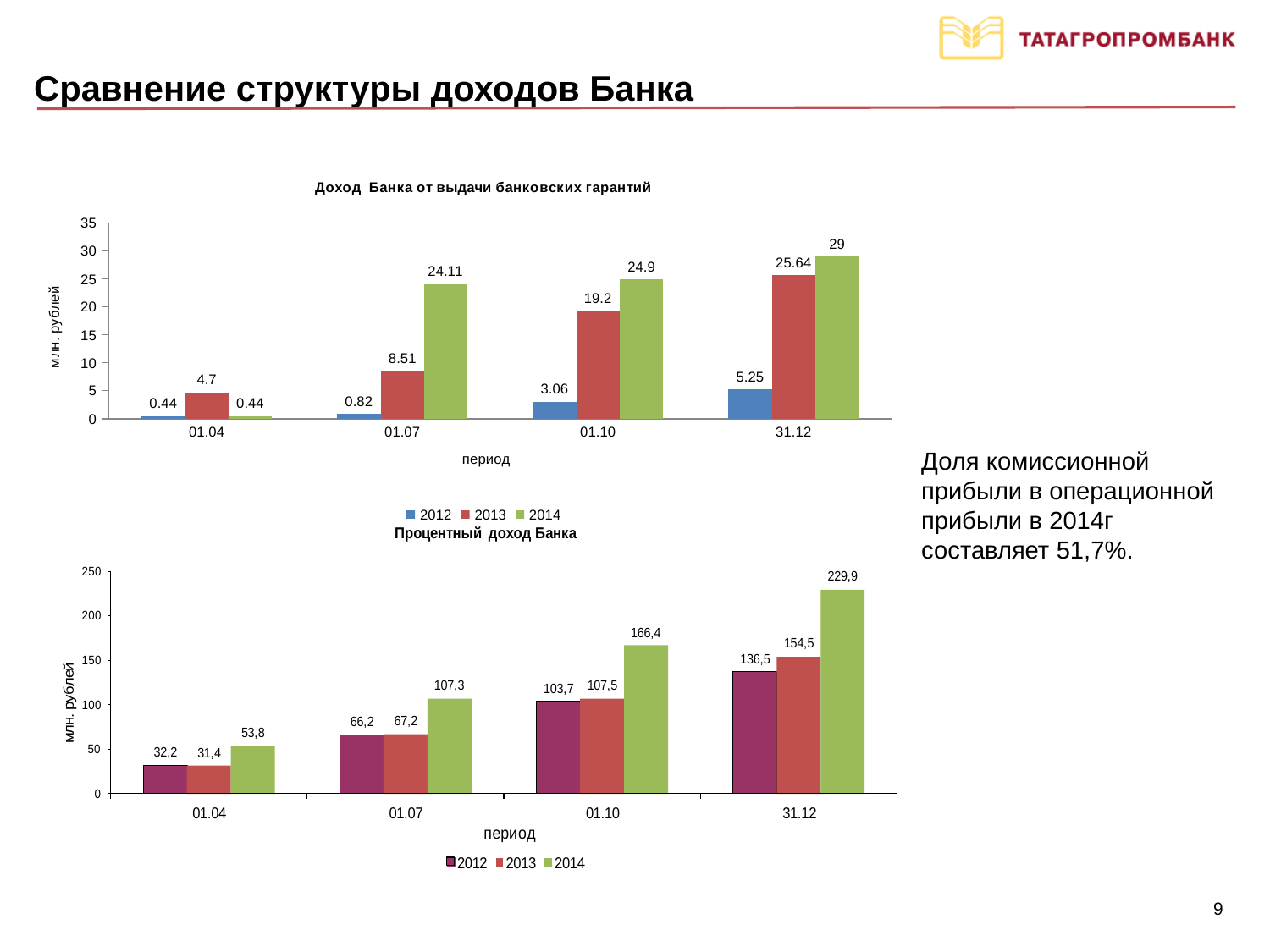
In the chart 'Доход Банка от выдачи банковских гарантий', how many series does the legend list? 3 In the chart 'Процентный доход Банка', what is the value for 2012 at 01.10? 103,7 In the chart 'Процентный доход Банка', what is the value for 2014 at 31.12? 229,9 In the chart 'Процентный доход Банка', which period has the lowest value for the 2014 series? 01.04 In the chart 'Доход Банка от выдачи банковских гарантий', which period has the highest value for the 2012 series? 31.12 In the chart 'Доход Банка от выдачи банковских гарантий', what is the value for 2014 at 31.12? 29 In the chart 'Процентный доход Банка', which is larger at 01.04: the 2012 value or the 2013 value? 2012 In the chart 'Доход Банка от выдачи банковских гарантий', what is the difference between the 2014 and 2013 values at 01.07? 15.6 In the chart 'Процентный доход Банка', how many periods are shown on the x axis? 4 In the chart 'Доход Банка от выдачи банковских гарантий', what is the value for 2013 at 01.07? 8.51 In the chart 'Процентный доход Банка', what is the difference between the 2014 and 2012 values at 31.12? 93,4 What type of chart is 'Процентный доход Банка'? Bar chart